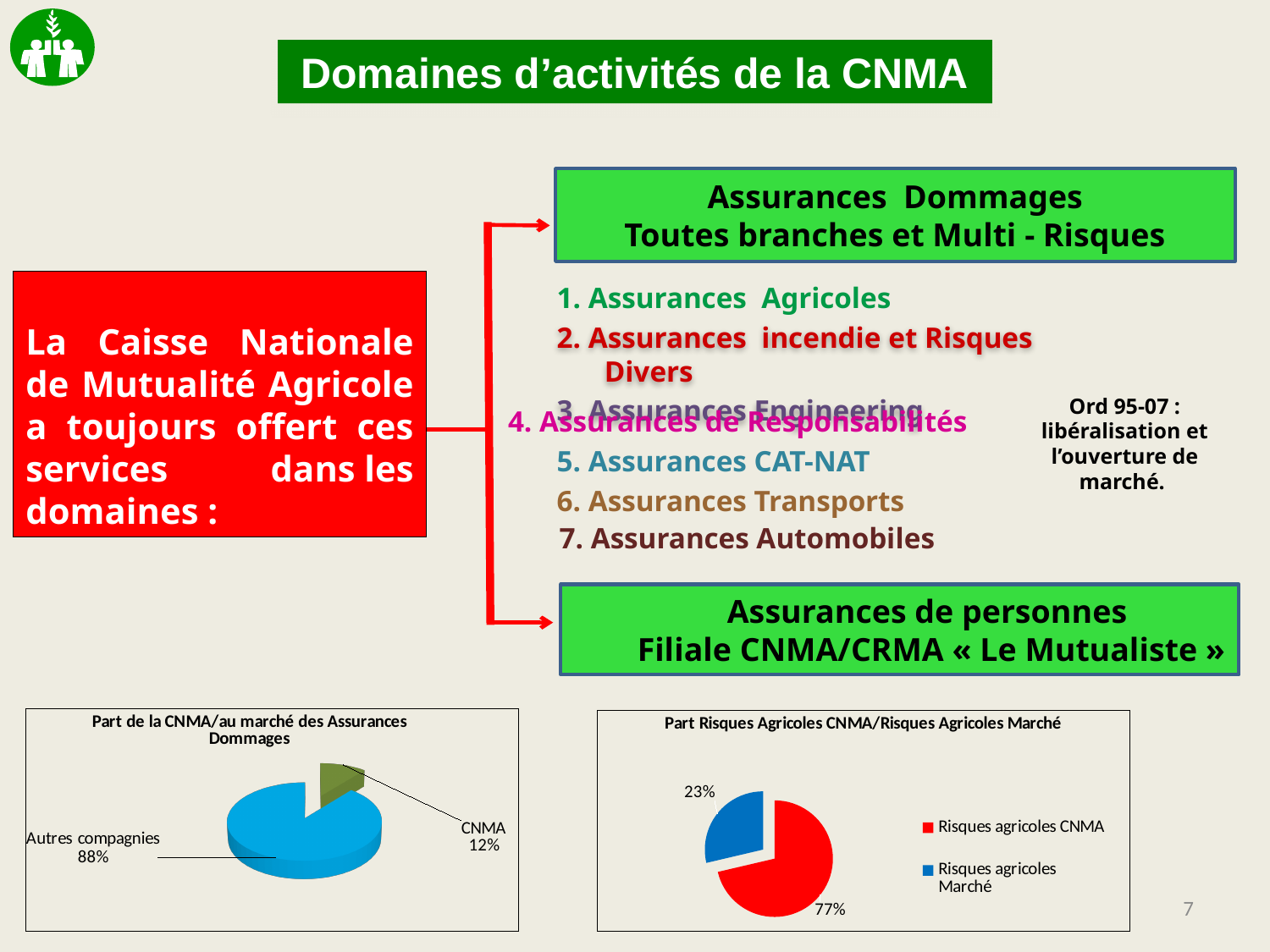
In the chart titled "Part de la CNMA/au marché des Assurances Dommages", what share is labelled for CNMA? 12% In the chart titled "Part Risques Agricoles CNMA/Risques Agricoles Marché", which is larger: Risques agricoles CNMA or Risques agricoles Marché? Risques agricoles CNMA In the chart titled "Part de la CNMA/au marché des Assurances Dommages", which slice is the largest? Autres compagnies In the chart titled "Part Risques Agricoles CNMA/Risques Agricoles Marché", what share is labelled for Risques agricoles CNMA? 77% In the chart titled "Part Risques Agricoles CNMA/Risques Agricoles Marché", what colour is the Risques agricoles CNMA slice? Red In the chart titled "Part Risques Agricoles CNMA/Risques Agricoles Marché", which slice is the smallest? Risques agricoles Marché How many entries does the legend of the chart titled "Part Risques Agricoles CNMA/Risques Agricoles Marché" list? 2 In the chart titled "Part Risques Agricoles CNMA/Risques Agricoles Marché", what share is labelled for Risques agricoles Marché? 23% In the chart titled "Part de la CNMA/au marché des Assurances Dommages", what is the difference in percentage points between Autres compagnies and CNMA? 76 percentage points In the chart titled "Part de la CNMA/au marché des Assurances Dommages", what share is labelled for Autres compagnies? 88% What kind of chart is the one titled "Part de la CNMA/au marché des Assurances Dommages"? Pie chart How many slices does the chart titled "Part de la CNMA/au marché des Assurances Dommages" have? 2